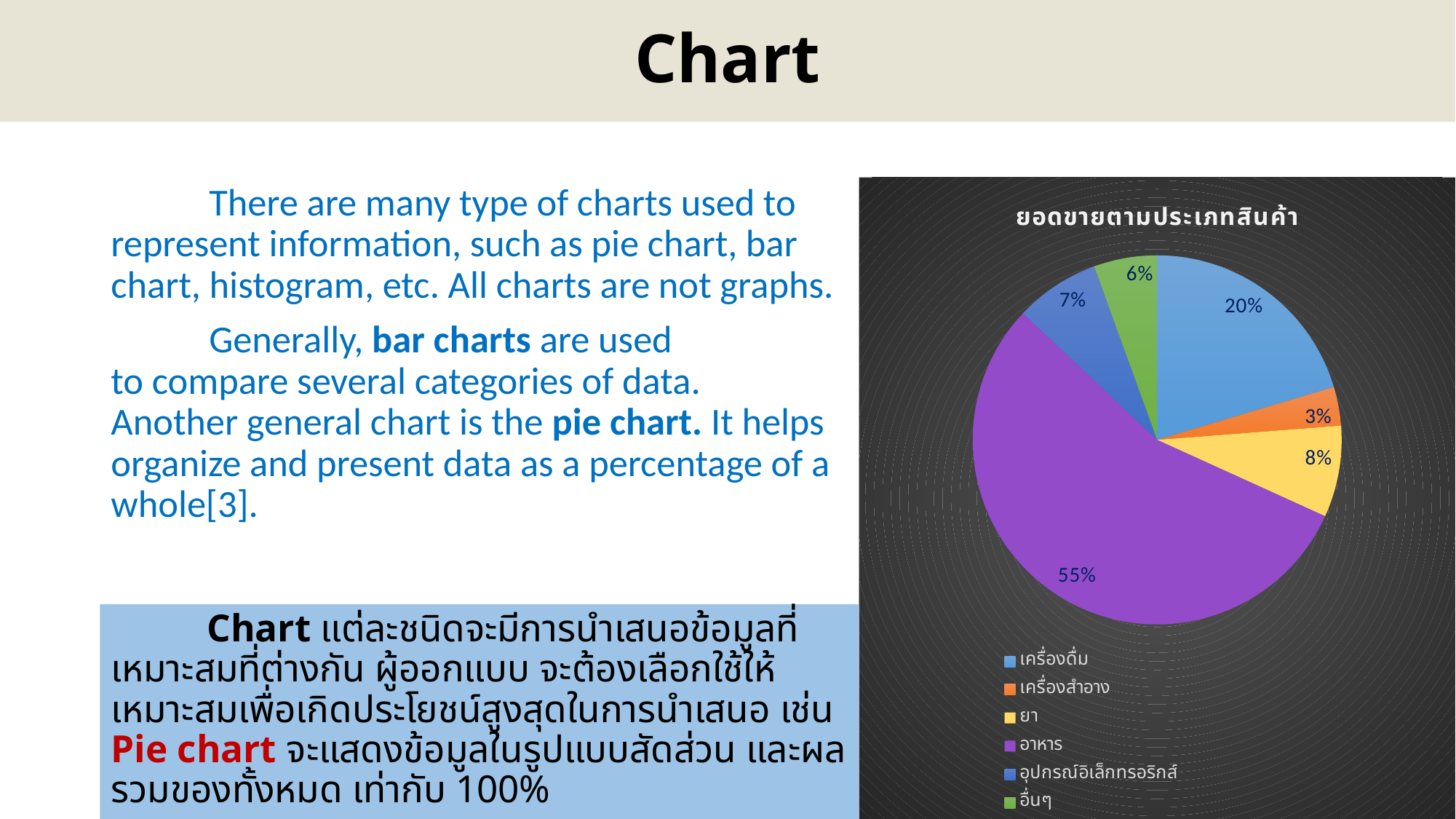
What kind of chart is shown on the slide? Pie chart What share of the pie does อาหาร have? 55% Which category has the largest slice of the pie? อาหาร What is the title of the pie chart? ยอดขายตามประเภทสินค้า How many categories does the pie chart's legend list? 6 Which category has the smallest slice of the pie? เครื่องสำอาง What share of the pie does เครื่องดื่ม have? 20% What share of the pie does ยา have? 8% What is the difference between the shares of อาหาร and เครื่องดื่ม? 35% Which colour represents อาหาร in the pie chart? Purple Which has a larger share, อุปกรณ์อิเล็กทรอนิกส์ or อื่นๆ? อุปกรณ์อิเล็กทรอริกส์